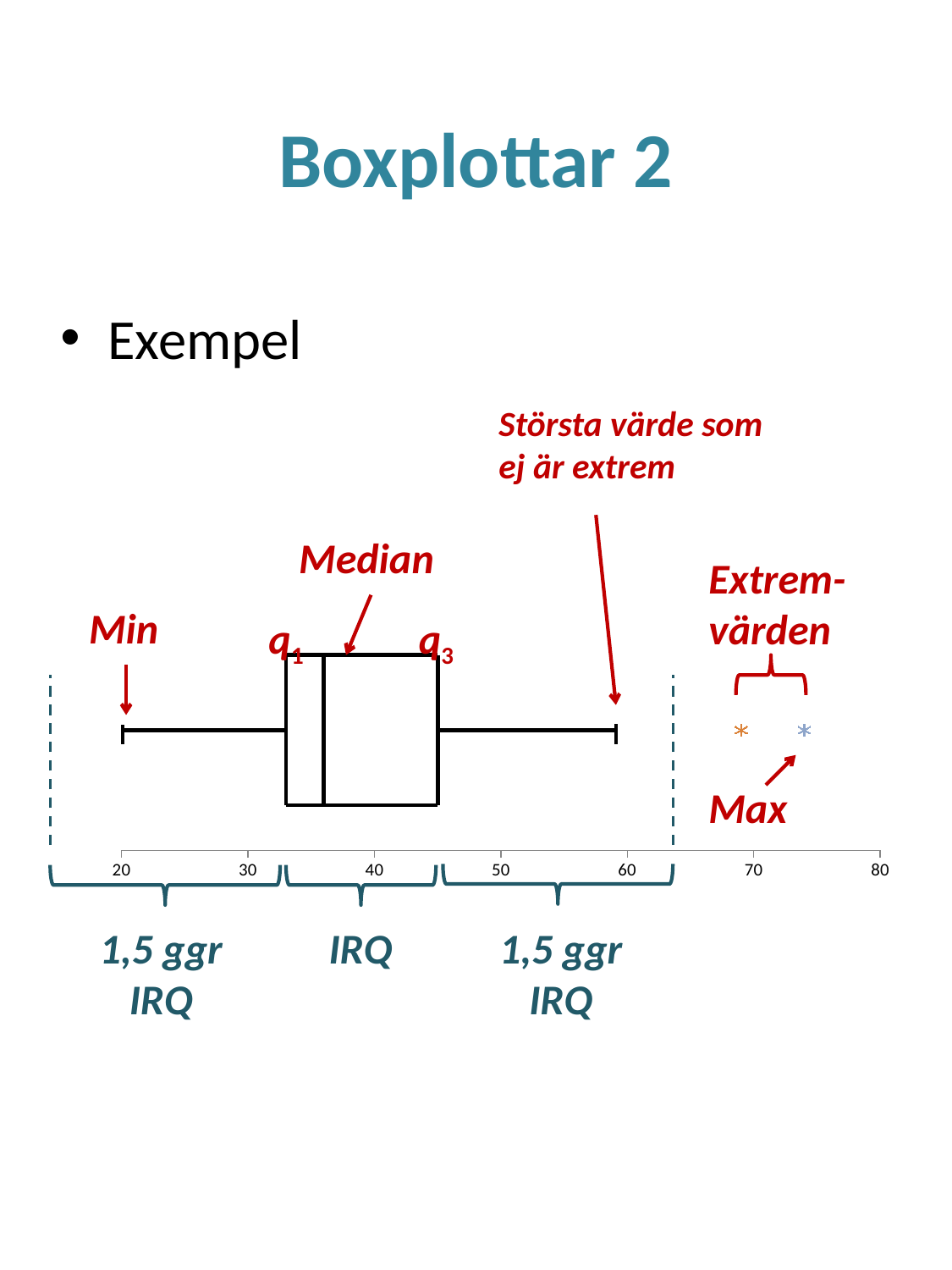
What kind of chart is shown on the slide? Box plot What is the lowest value shown on the horizontal axis of the box plot? 20 What is the title of the slide containing the box plot? Boxplottar 2 Is q1 of the box plot greater or less than 30? greater Is q3 of the box plot greater or less than 50? less How many extreme values (Extremvärden) are plotted as asterisks in the box plot? 2 What is the highest value shown on the horizontal axis of the box plot? 80 Is the median of the box plot greater or less than 40? less Which is larger in the box plot, the median or q3? q3